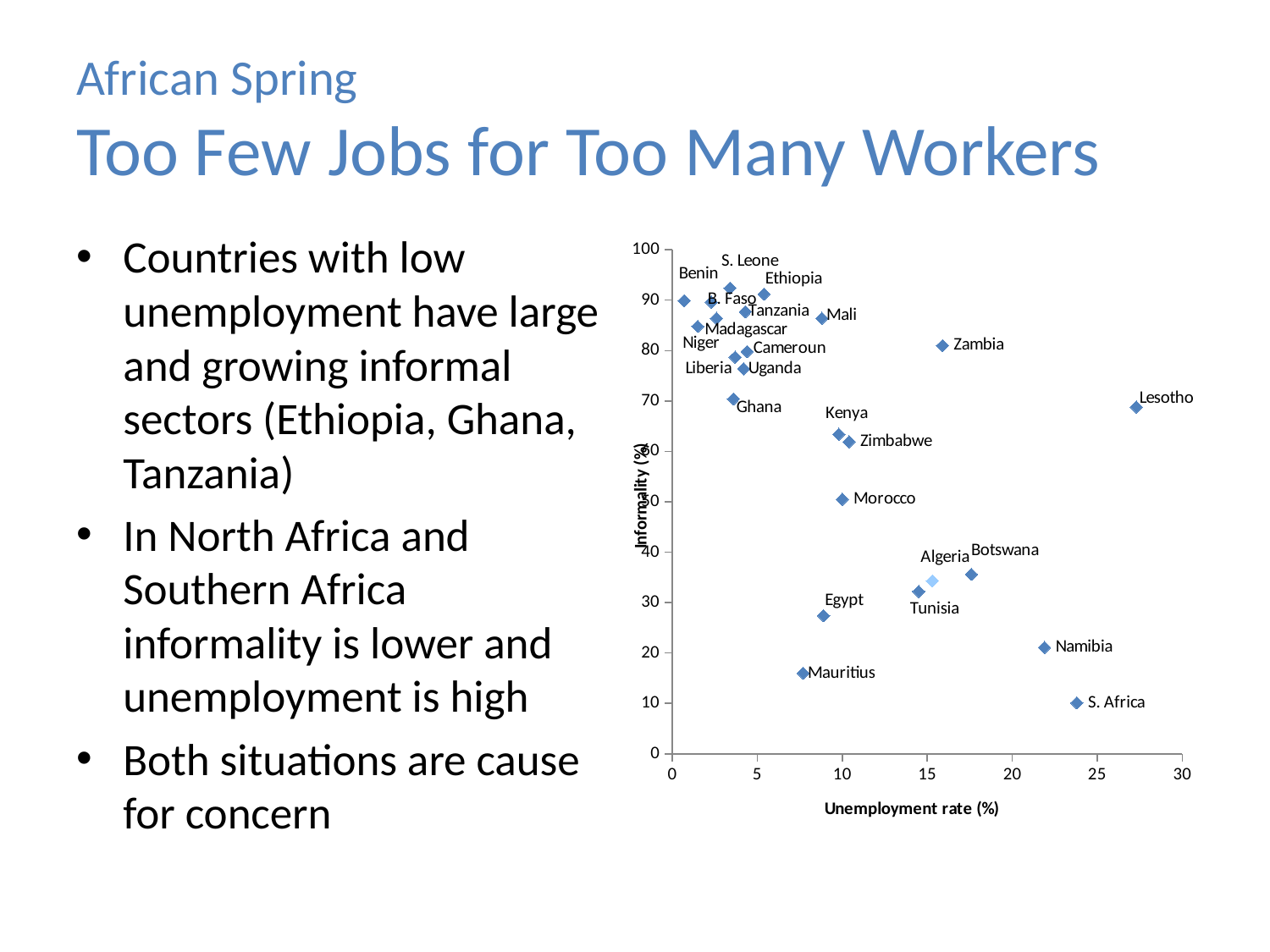
Which has the higher informality value, Namibia or S. Africa? Namibia What kind of chart is shown on the slide? scatter chart Is the unemployment rate for Namibia greater or less than 20? greater What is the label of the x axis of the chart? Unemployment rate (%) Which country has the lowest unemployment rate in the chart? Benin Is the informality value for Kenya greater or less than 60? greater Is the informality value for Mauritius greater or less than 20? less Which has the higher unemployment rate, Lesotho or Zambia? Lesotho Which country has the lowest informality in the chart? S. Africa Which country has the highest unemployment rate in the chart? Lesotho What is the label of the y axis of the chart? Informality (%)